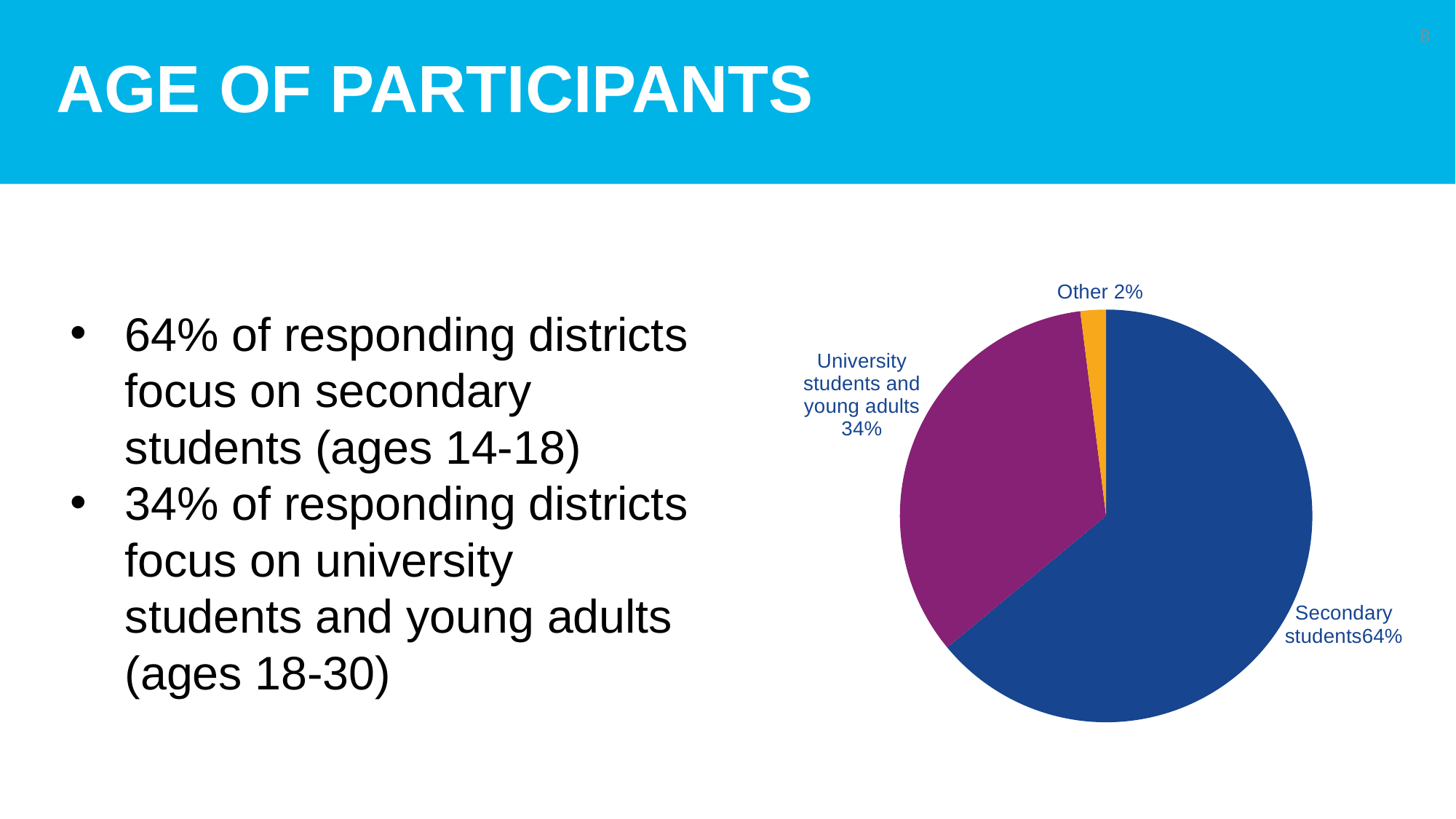
What is the difference in percentage points between the University students and young adults slice and the Other slice? 32 What colour is the Secondary students slice of the pie? dark blue Which slice of the pie is the smallest? Other Which is larger, the University students and young adults slice or the Other slice? University students and young adults What share of the pie is labelled University students and young adults? 34% What share of the pie is labelled Other? 2% What kind of chart is shown on the slide? pie chart What is the difference in percentage points between the Secondary students slice and the University students and young adults slice? 30 How many slices does the pie chart have? 3 What colour is the Other slice of the pie? orange What share of the pie is labelled Secondary students? 64% Which slice of the pie is the largest? Secondary students